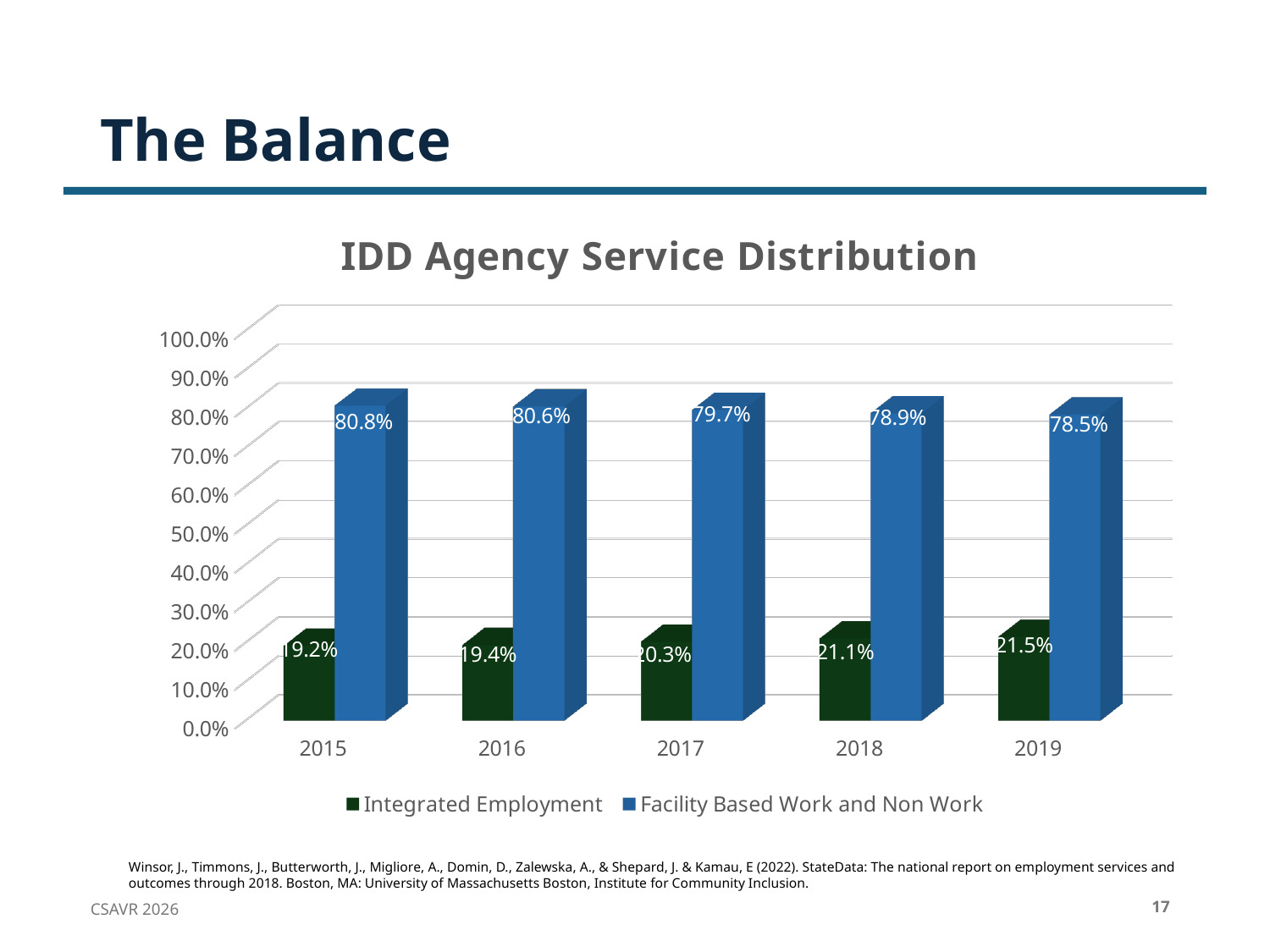
What is the Facility Based Work and Non Work value for 2019? 78.5% Which year has the highest Facility Based Work and Non Work value? 2015 How many years are shown on the x axis? 5 What is the Integrated Employment value for 2015? 19.2% What is the difference between the Facility Based Work and Non Work values for 2015 and 2019? 2.3% Is the Facility Based Work and Non Work value for 2017 greater or less than 70.0%? greater Which is larger, the Integrated Employment value for 2018 or for 2016? 2018 Which year has the lowest Integrated Employment value? 2015 What kind of chart is shown on the slide? Bar chart Does the Integrated Employment value rise or fall from 2015 to 2019? Rise What is the Integrated Employment value for 2017? 20.3% How many series does the legend list? 2